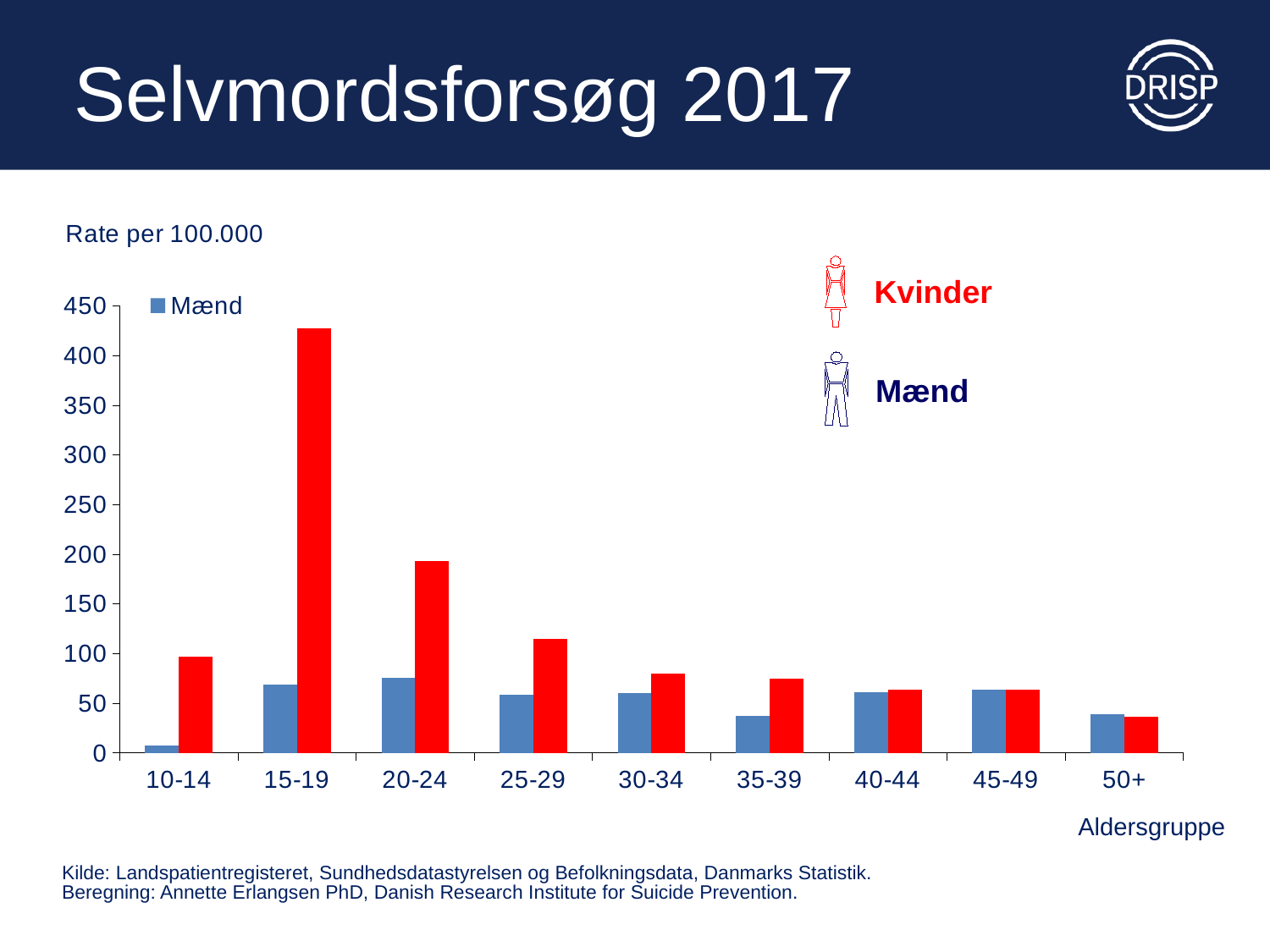
Which age group has the lowest value for Kvinder? 50+ What is the title of the slide? Selvmordsforsøg 2017 Do the values for Kvinder rise or fall from the 15-19 age group to the 50+ age group? fall In the 15-19 age group, which is larger: the value for Kvinder or for Mænd? Kvinder What kind of chart is shown on the slide? bar chart Is the value for Mænd in the 20-24 age group greater or less than 50? greater Which age group has the lowest value for Mænd? 10-14 Is the value for Kvinder in the 15-19 age group greater or less than 400? greater Is the value for Mænd in the 10-14 age group greater or less than 50? less How many age groups are shown on the x axis? 9 Which age group has the highest value for Kvinder? 15-19